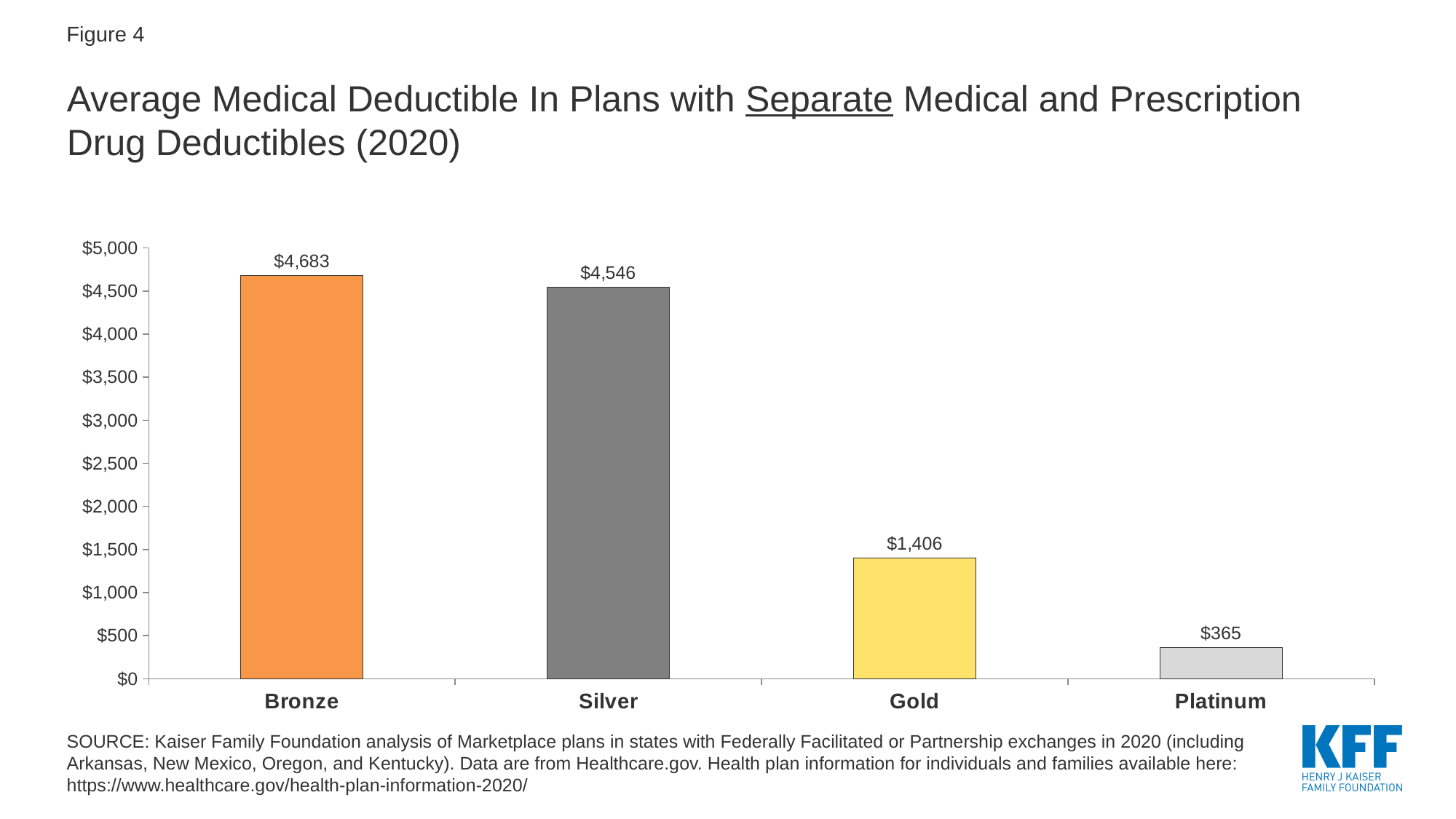
What is the average medical deductible for Silver plans? $4,546 Which plan type has the lowest average medical deductible? Platinum What is the average medical deductible for Bronze plans? $4,683 What is the average medical deductible for Gold plans? $1,406 Which plan type has the highest average medical deductible? Bronze What is the difference between the Gold and Platinum average medical deductibles? $1,041 What is the average medical deductible for Platinum plans? $365 Which is larger, the average medical deductible for Gold or for Platinum? Gold How many plan types are shown in the chart? 4 Do the values rise or fall moving from Bronze to Platinum along the x axis? Fall What is the difference between the Bronze and Silver average medical deductibles? $137 What kind of chart is shown on the slide? Bar chart